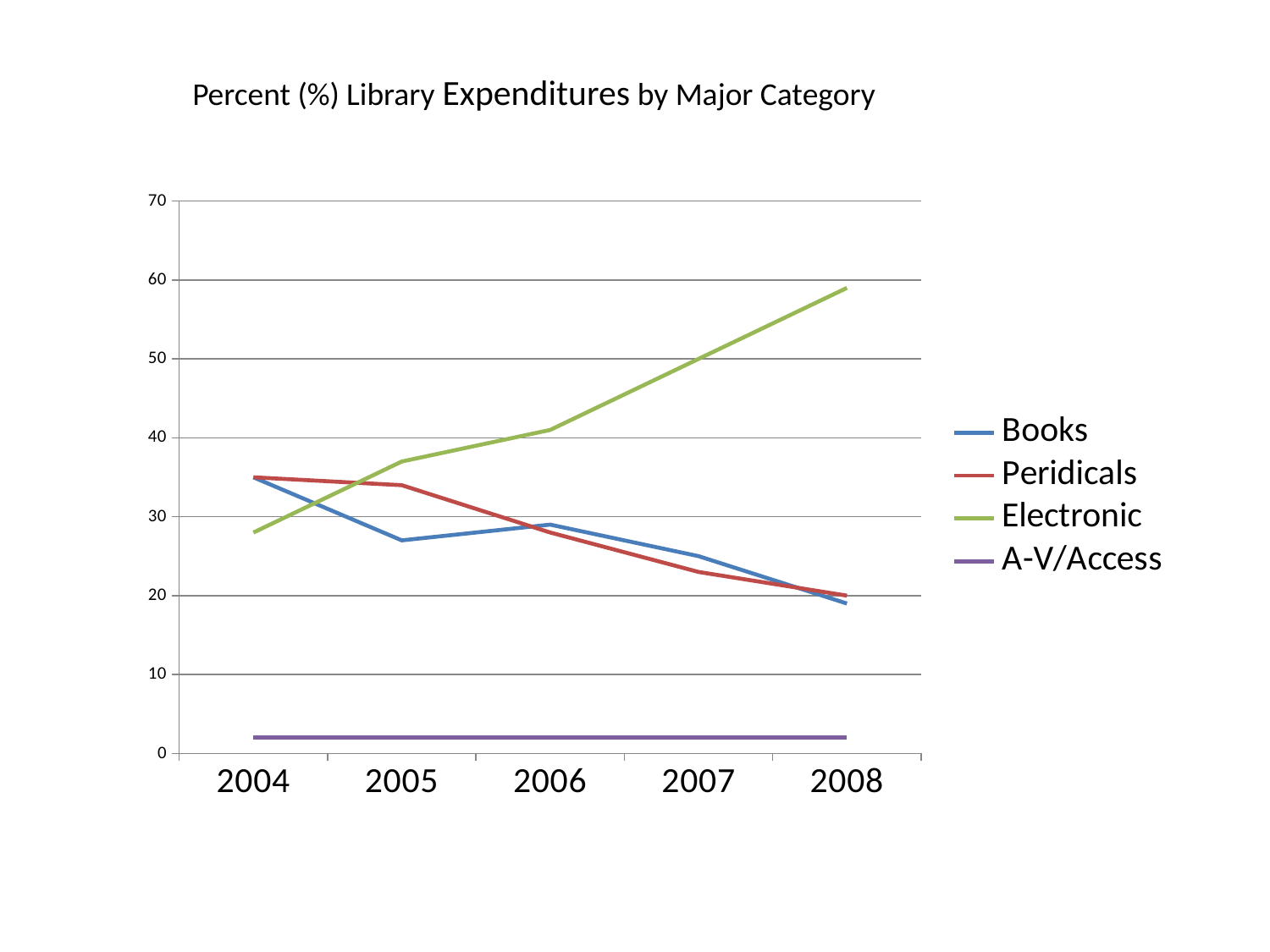
How many series does the legend list? 4 In 2008, which is larger: Electronic or Peridicals? Electronic Which series has the highest value in 2008? Electronic Is the value for A-V/Access in 2006 greater or less than 10? less Is the value for Books in 2005 greater or less than 30? less Which series has the lowest value in 2004? A-V/Access Does the Books line rise or fall from 2004 to 2008? fall Does the Electronic line rise or fall from 2004 to 2008? rise What kind of chart is shown on the slide? line chart Does the Peridicals line rise or fall from 2004 to 2008? fall How many years are plotted along the x axis? 5 Is the value for Electronic in 2008 greater or less than 50? greater